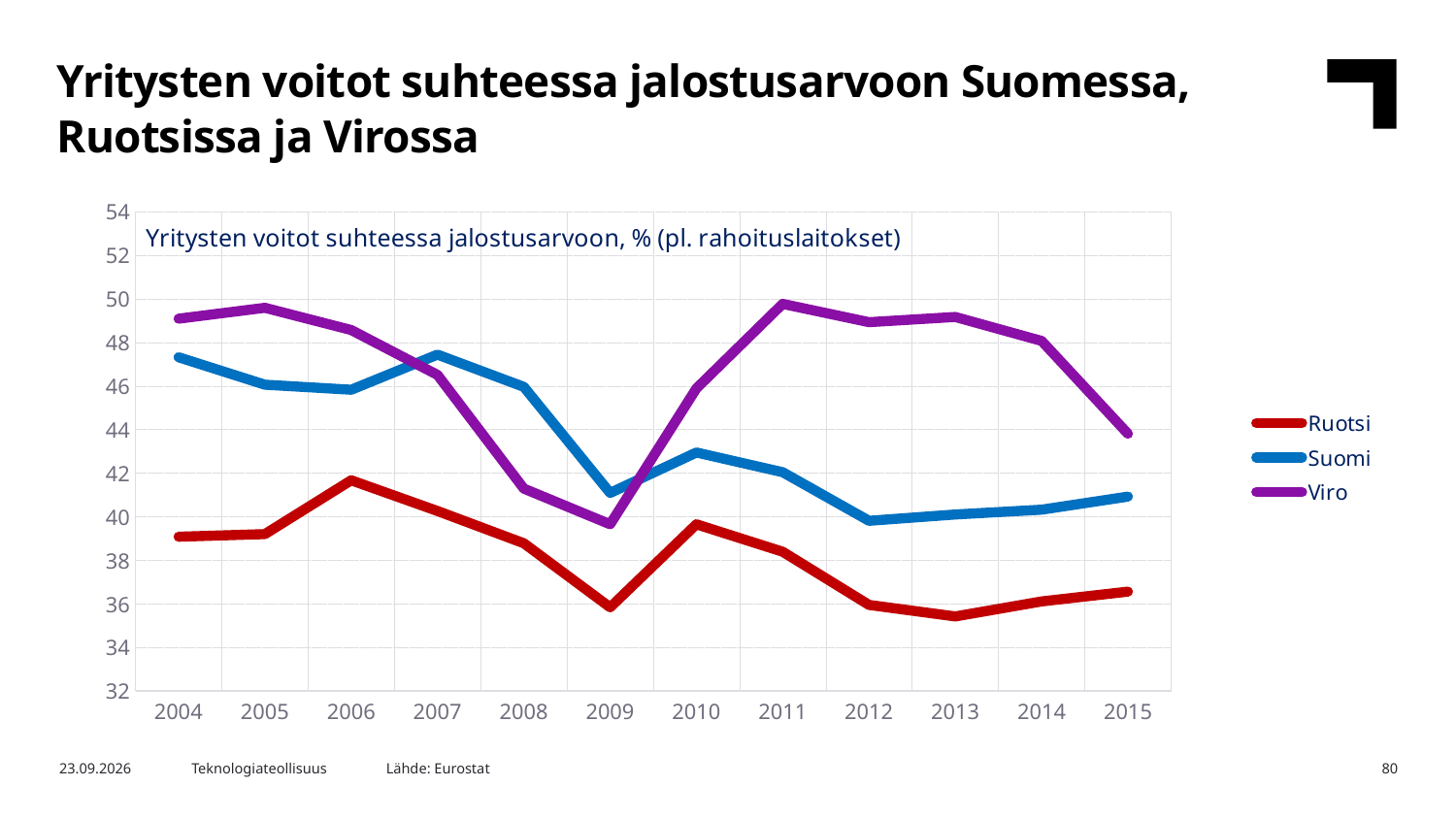
How many series does the legend list? 3 Which series are listed in the legend? Ruotsi, Suomi, Viro Is the value for Viro in 2015 greater or less than 46? less In which year does Ruotsi reach its highest value? 2006 How many years are shown on the x axis? 12 Is the value for Ruotsi in 2009 greater or less than 38? less Is the value for Viro in 2011 greater or less than 48? greater In 2013, which is higher, Suomi or Ruotsi? Suomi What kind of chart is shown on the slide? line chart What is the title printed inside the chart area? Yritysten voitot suhteessa jalostusarvoon, % (pl. rahoituslaitokset) In which year does Viro reach its lowest value? 2009